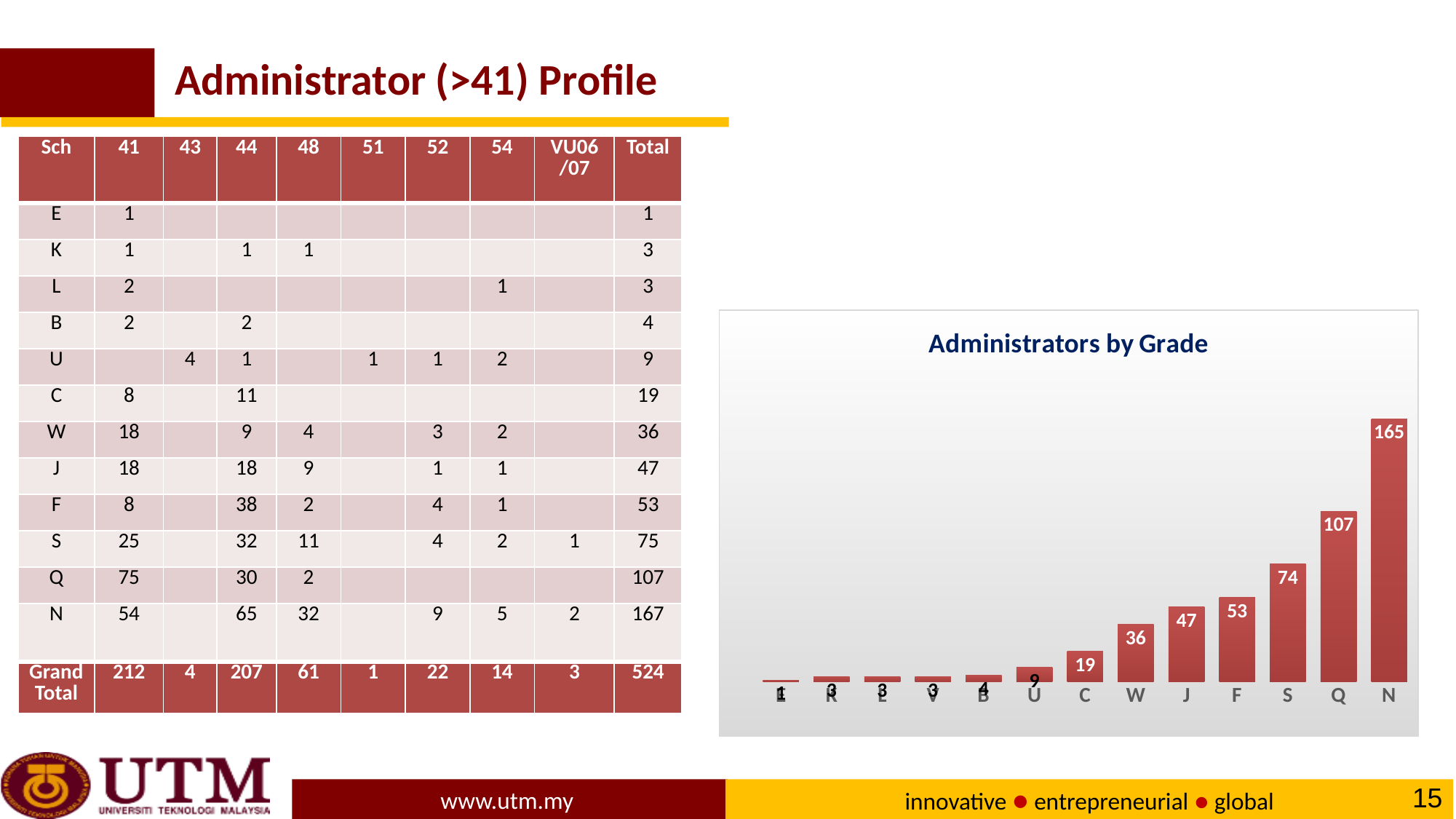
What is the value for grade C in the chart? 19 What is the title of the chart? Administrators by Grade What kind of chart is shown on the slide? bar chart How many bars are plotted in the chart? 13 Which is larger in the chart, the value for W or the value for J? J What is the value for grade N in the chart? 165 What is the value for grade S in the chart? 74 What is the difference between the values for N and Q in the chart? 58 Which grade has the highest number of administrators in the chart? N What is the difference between the values for F and J in the chart? 6 What is the value for grade Q in the chart? 107 Do the values in the chart rise or fall from left to right along the x axis? rise